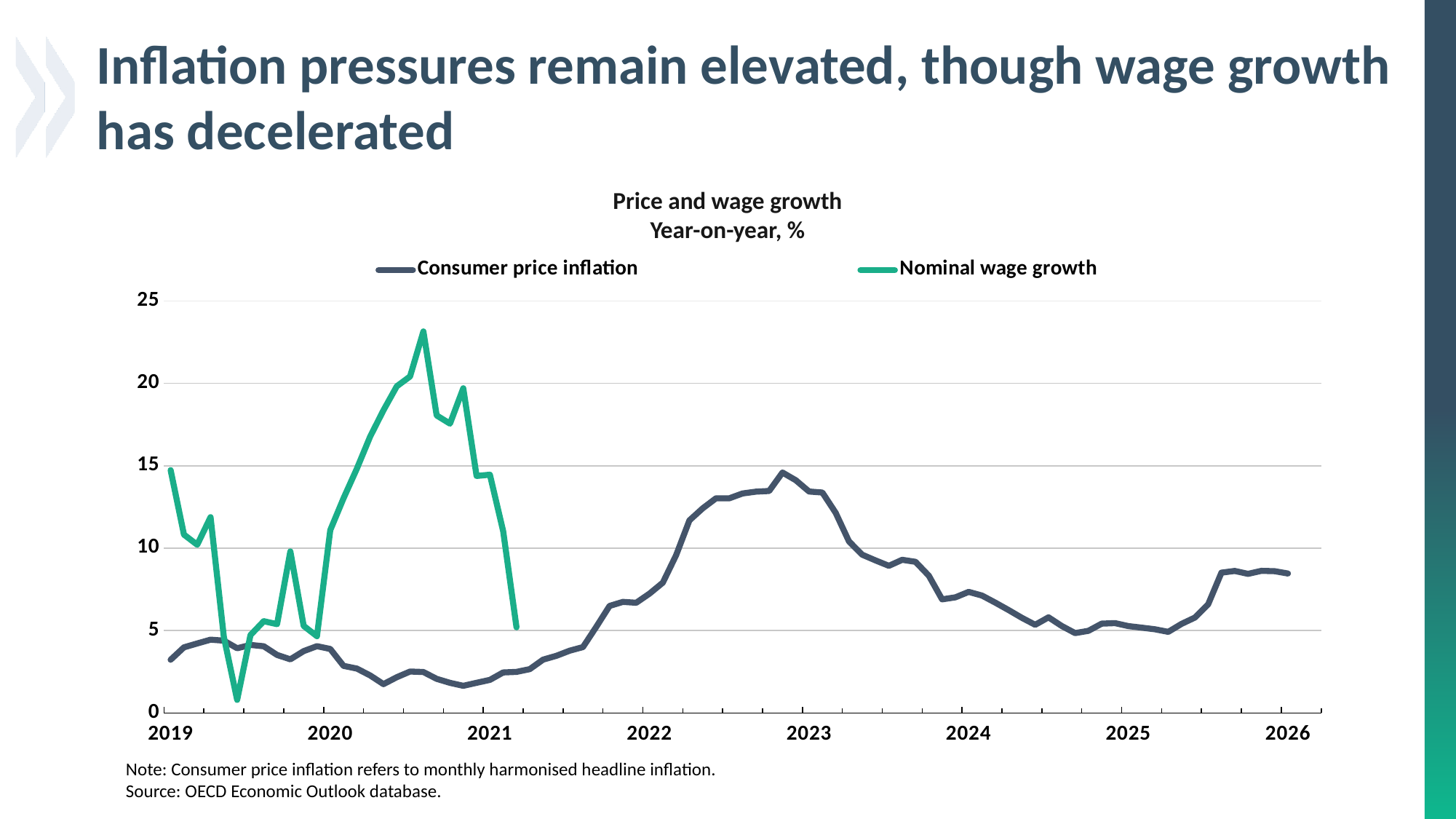
Is the peak value of Consumer price inflation greater or less than 15? less Is the peak value of Nominal wage growth greater or less than 20? greater Which series is drawn in green? Nominal wage growth Is the value of Consumer price inflation at the start of 2019 greater or less than 5? less How many series does the legend list? 2 How many year labels are shown on the x axis? 8 What is the title of the chart? Price and wage growth, Year-on-year, % What kind of chart is shown on the slide? line chart Which series reaches the higher peak value, Consumer price inflation or Nominal wage growth? Nominal wage growth At the start of 2021, which series has the higher value, Consumer price inflation or Nominal wage growth? Nominal wage growth Does Consumer price inflation rise or fall between the start of 2023 and the start of 2025? fall